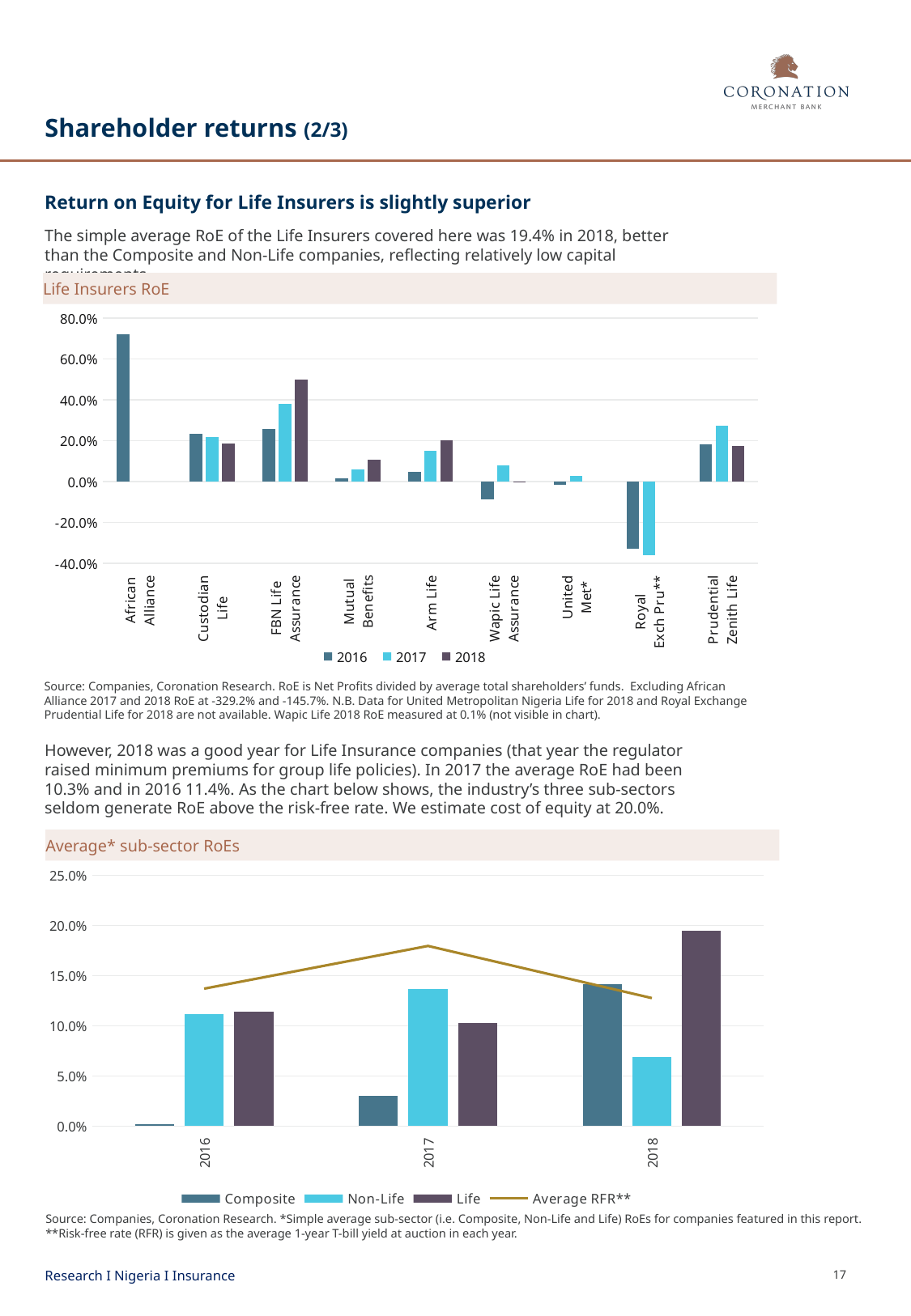
What kind of chart is the Average* sub-sector RoEs chart? Bar chart with a line In the Average* sub-sector RoEs chart, is the Non-Life value for 2017 greater or less than 10.0%? greater In the Average* sub-sector RoEs chart, do the Composite values rise or fall from 2016 to 2018? rise In the Life Insurers RoE chart, which is larger for Custodian Life: the 2016 value or the 2018 value? 2016 In the Life Insurers RoE chart, how many series does the legend list? 3 In the Life Insurers RoE chart, is the 2016 value for African Alliance greater or less than 60.0%? greater In the Average* sub-sector RoEs chart, which sub-sector has the highest bar in 2018? Life In the Life Insurers RoE chart, is the 2018 value for FBN Life Assurance greater or less than 40.0%? greater In the Life Insurers RoE chart, which insurer has the highest bar? African Alliance In the Life Insurers RoE chart, how many insurers are shown on the x axis? 9 In the Average* sub-sector RoEs chart, how many entries does the legend list? 4